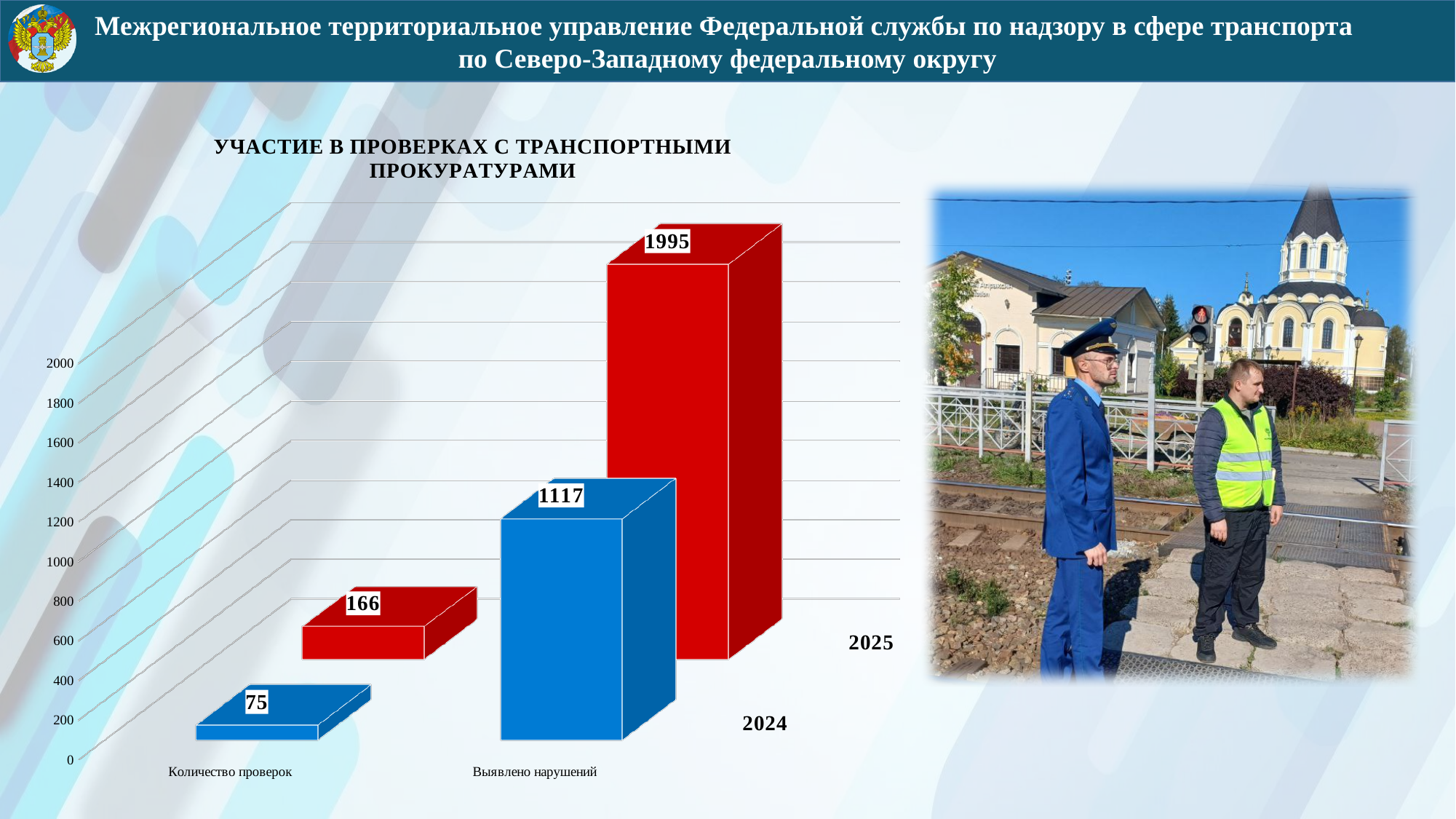
What is the difference between the 2025 and 2024 values for "Количество проверок"? 91 Which bar has the highest value on the chart? Выявлено нарушений, 2025 Which bar has the lowest value on the chart? Количество проверок, 2024 How many categories are shown on the x axis of the chart? 2 What is the value for "Количество проверок" in 2025? 166 What is the difference between the 2025 and 2024 values for "Выявлено нарушений"? 878 What is the title of the chart? УЧАСТИЕ В ПРОВЕРКАХ С ТРАНСПОРТНЫМИ ПРОКУРАТУРАМИ What is the value for "Выявлено нарушений" in 2025? 1995 What type of chart is shown on the slide? Bar chart What is the value for "Выявлено нарушений" in 2024? 1117 What is the value for "Количество проверок" in 2024? 75 Which is larger: "Выявлено нарушений" in 2024 or "Выявлено нарушений" in 2025? 2025